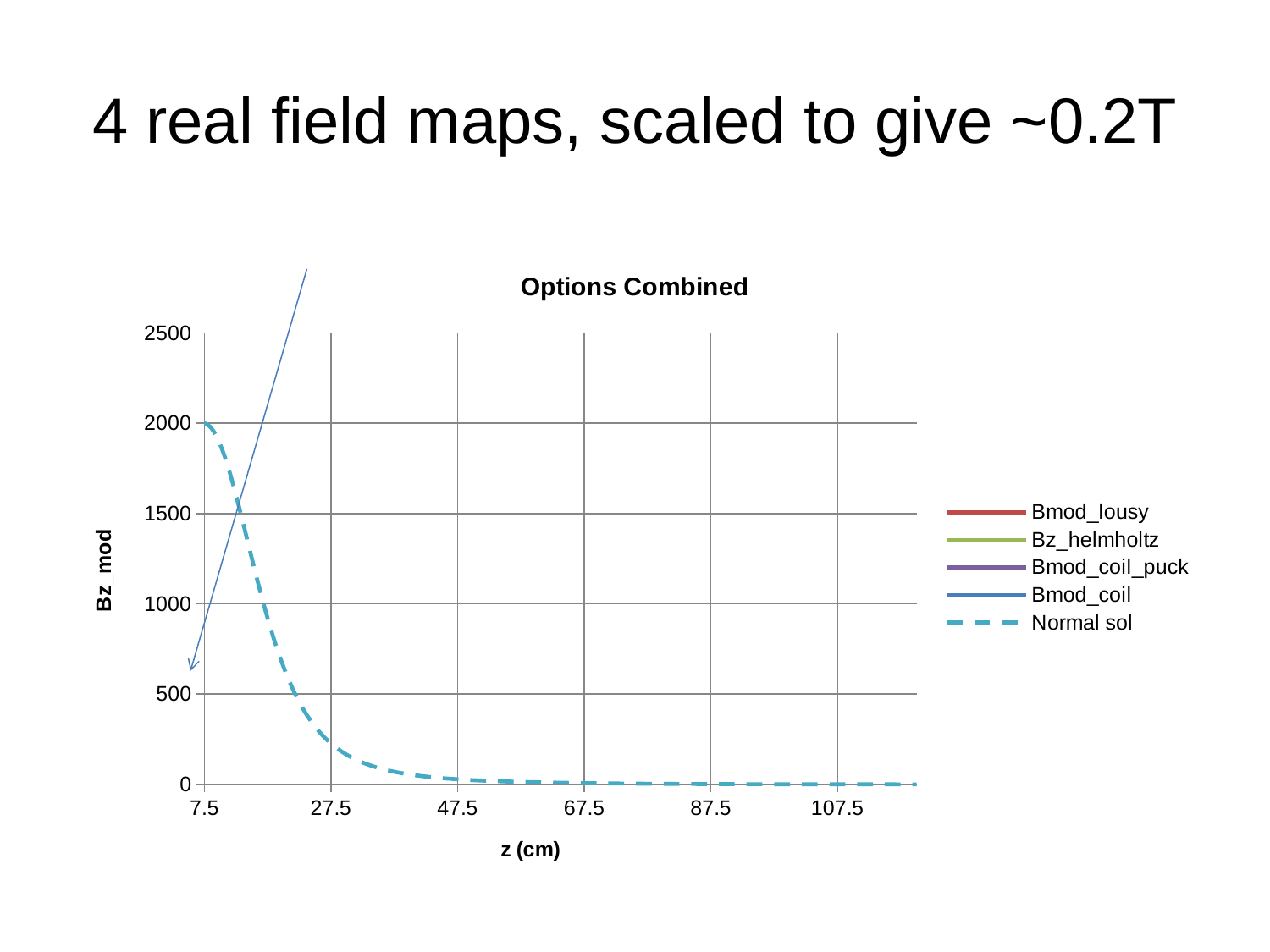
Is the value of Normal sol at z = 27.5 greater or less than 500? less Does the Normal sol line rise or fall as z increases? fall Is the value of Normal sol at z = 47.5 greater or less than 500? less What is the label of the y axis? Bz_mod What is the label of the x axis? z (cm) Which legend entry is drawn with a dashed line? Normal sol What kind of chart is shown on the slide? line chart Is the value of Normal sol at z = 7.5 greater or less than 1500? greater What is the highest value labelled on the y axis? 2500 What is the largest z value labelled on the x axis? 107.5 How many series does the chart's legend list? 5 What is the title of the chart? Options Combined